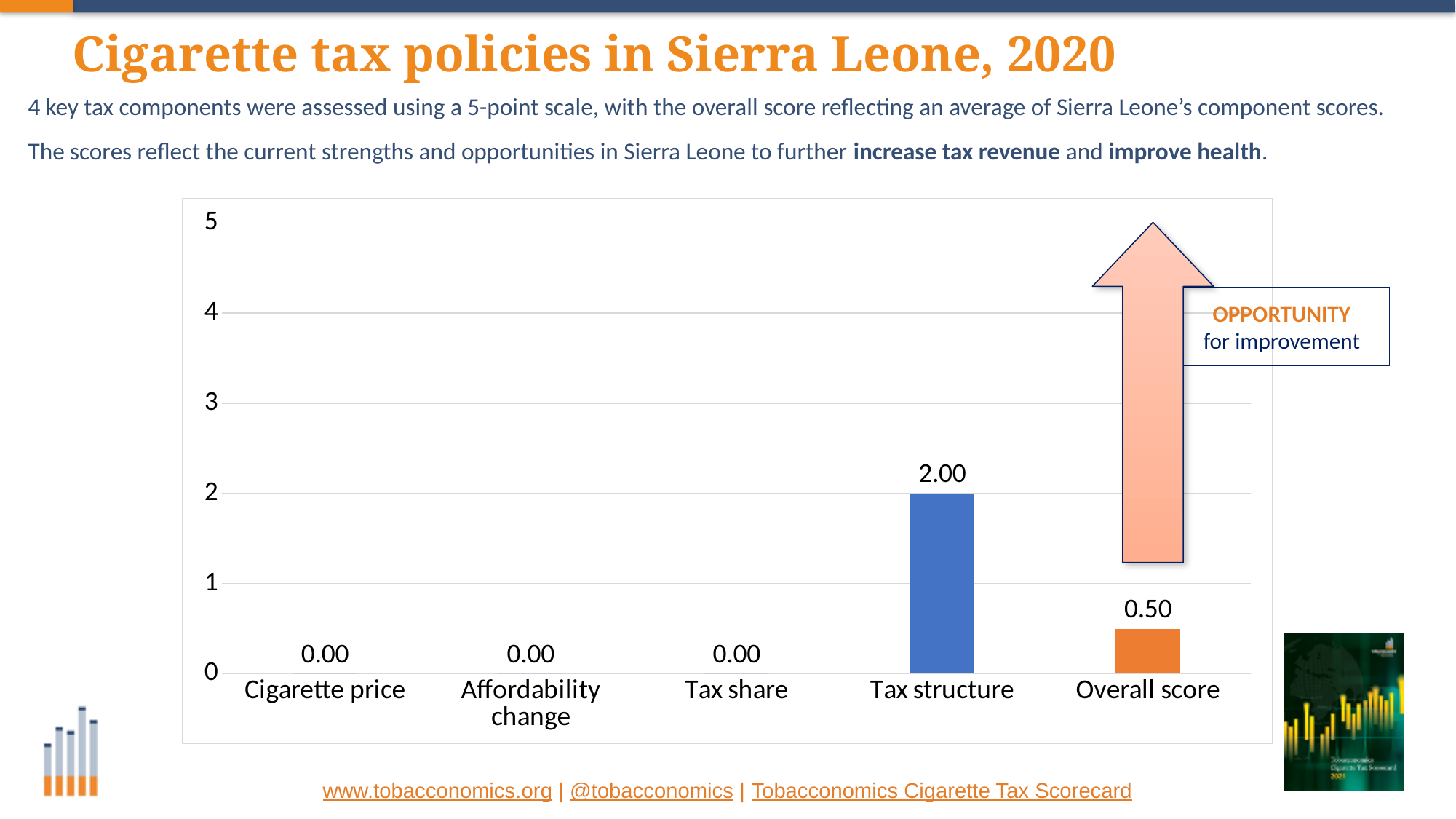
How many categories are shown on the x axis? 5 How many categories have a value of 0.00? 3 What is the value for Cigarette price? 0.00 Which is larger, the value for Tax structure or the value for Overall score? Tax structure What is the value for Tax structure? 2.00 What is the value for Overall score? 0.50 Is the value for Tax structure greater or less than 1? greater What is the value for Tax share? 0.00 Which category has the highest value? Tax structure What kind of chart is shown on the slide? bar chart What is the difference between the Tax structure value and the Overall score value? 1.50 What is the maximum value shown on the y axis? 5